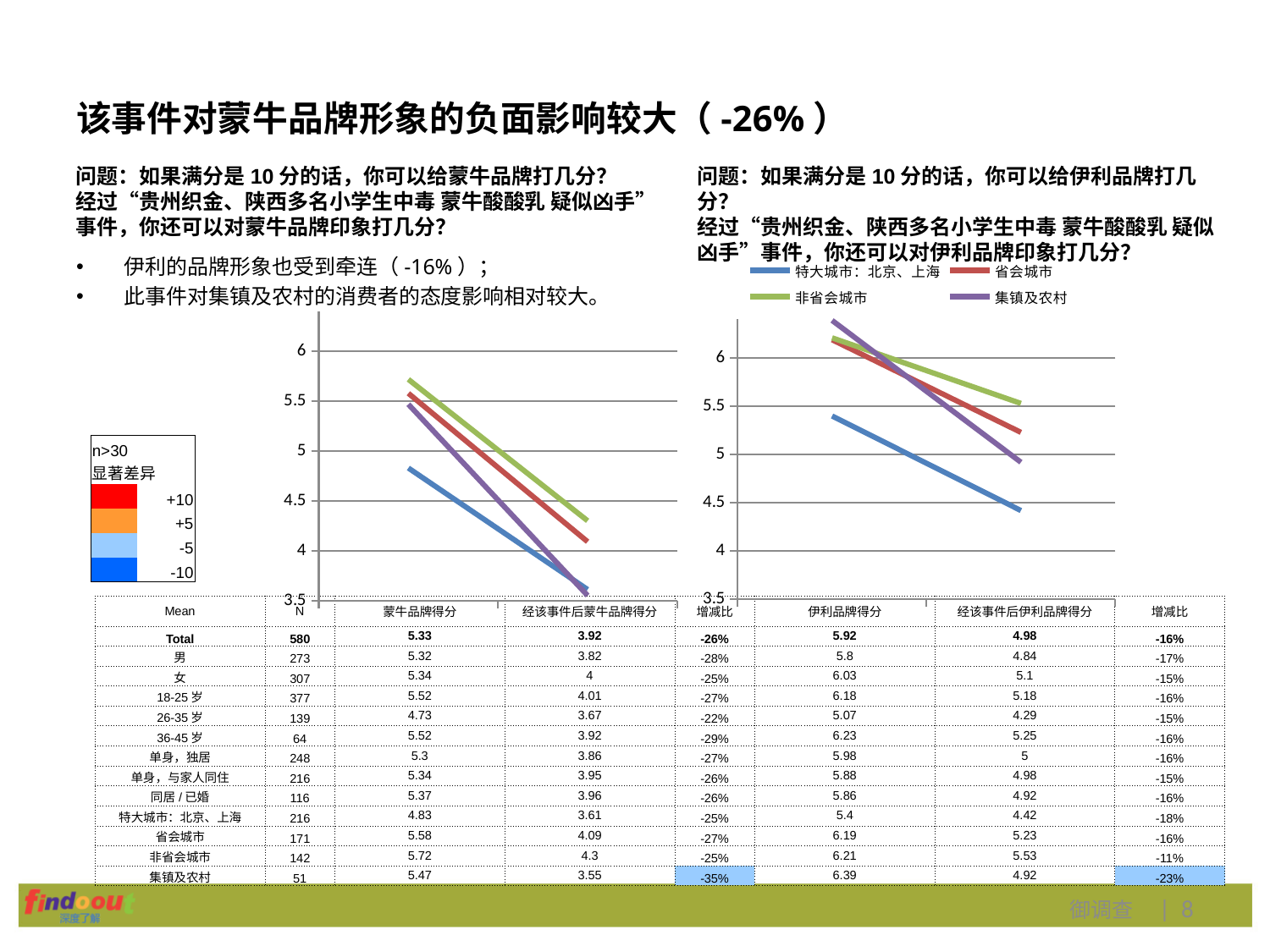
Which colour is used for the 省会城市 series in the charts? red How many series does the legend list for the charts? 4 In the left chart, is the starting value of the green line (非省会城市) greater or less than 5.5? greater According to the table, what is the 蒙牛品牌得分 for 集镇及农村? 5.47 In the left chart, which series has the lowest starting value? 特大城市：北京、上海 In the right chart, which series ends at the lowest value? 特大城市：北京、上海 In the left chart, do the values rise or fall from the first point to the second point along the x axis? fall What kind of chart is the left chart on the slide? line chart In the right chart, is the starting value of the blue line (特大城市：北京、上海) greater or less than 5.5? less In the left chart, which series ends lower: 省会城市 or 集镇及农村? 集镇及农村 According to the table, what is the 经该事件后伊利品牌得分 for 非省会城市? 5.53 In the right chart, which series has the highest starting value? 集镇及农村